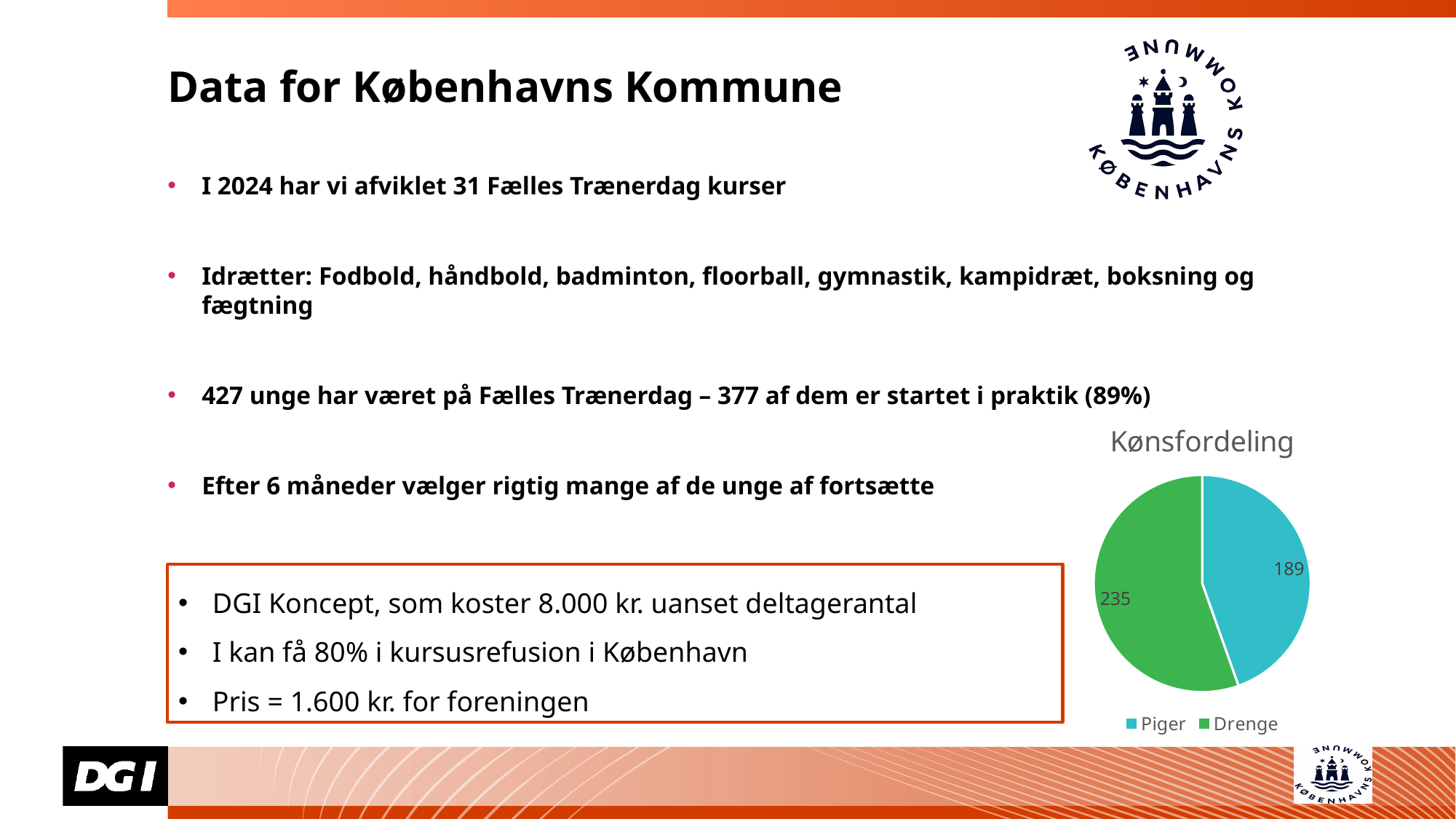
What is the title of the pie chart on the slide? Kønsfordeling In the Kønsfordeling pie chart, what is the value for Piger? 189 In the Kønsfordeling pie chart, which colour represents Drenge? green In the Kønsfordeling pie chart, which category has the largest slice? Drenge What is the total of the two values shown in the Kønsfordeling pie chart? 424 In the Kønsfordeling pie chart, what is the difference between the values for Drenge and Piger? 46 In the Kønsfordeling pie chart, which is larger, Piger or Drenge? Drenge How many slices does the Kønsfordeling pie chart have? 2 What type of chart is shown under the title "Kønsfordeling"? pie chart In the Kønsfordeling pie chart, which category has the smallest slice? Piger In the Kønsfordeling pie chart, what is the value for Drenge? 235 How many entries does the legend of the Kønsfordeling pie chart list? 2